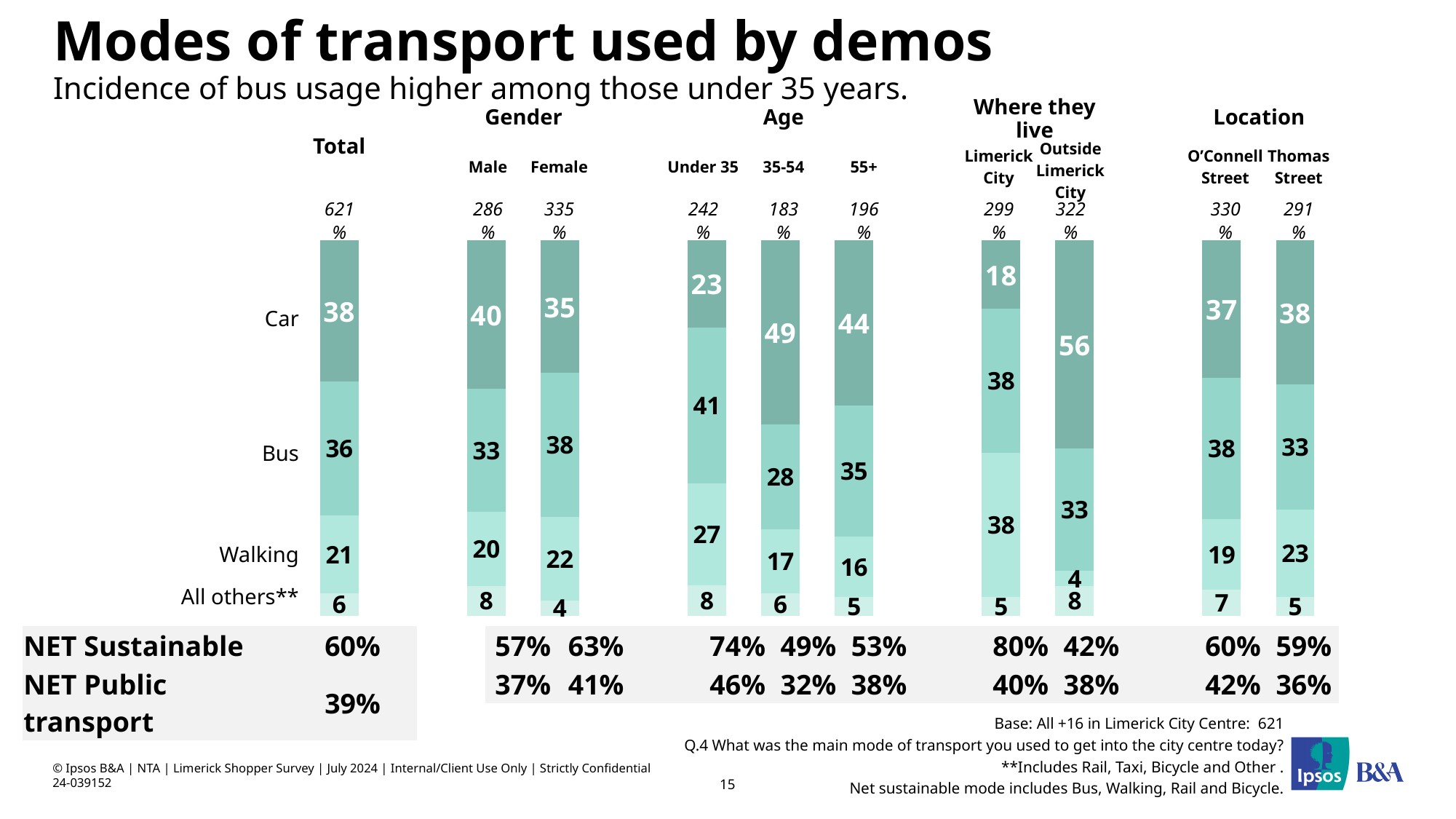
What is the difference in car usage between Male and Female? 5 Which group has the lowest 'All others' share? Female What percentage of Thomas Street respondents were walking? 23 What is the NET Sustainable figure for Limerick City? 80% Which group has the highest car usage across all bars? Outside Limerick City Which age group has the highest bus usage? Under 35 What percentage of the Total group used a car? 38 How many bars are shown in the chart? 10 Which has a higher walking share, Under 35 or 55+? Under 35 What percentage of those Under 35 used the bus? 41 How many transport mode segments make up each bar? 4 What type of chart is shown on the slide? Stacked bar chart